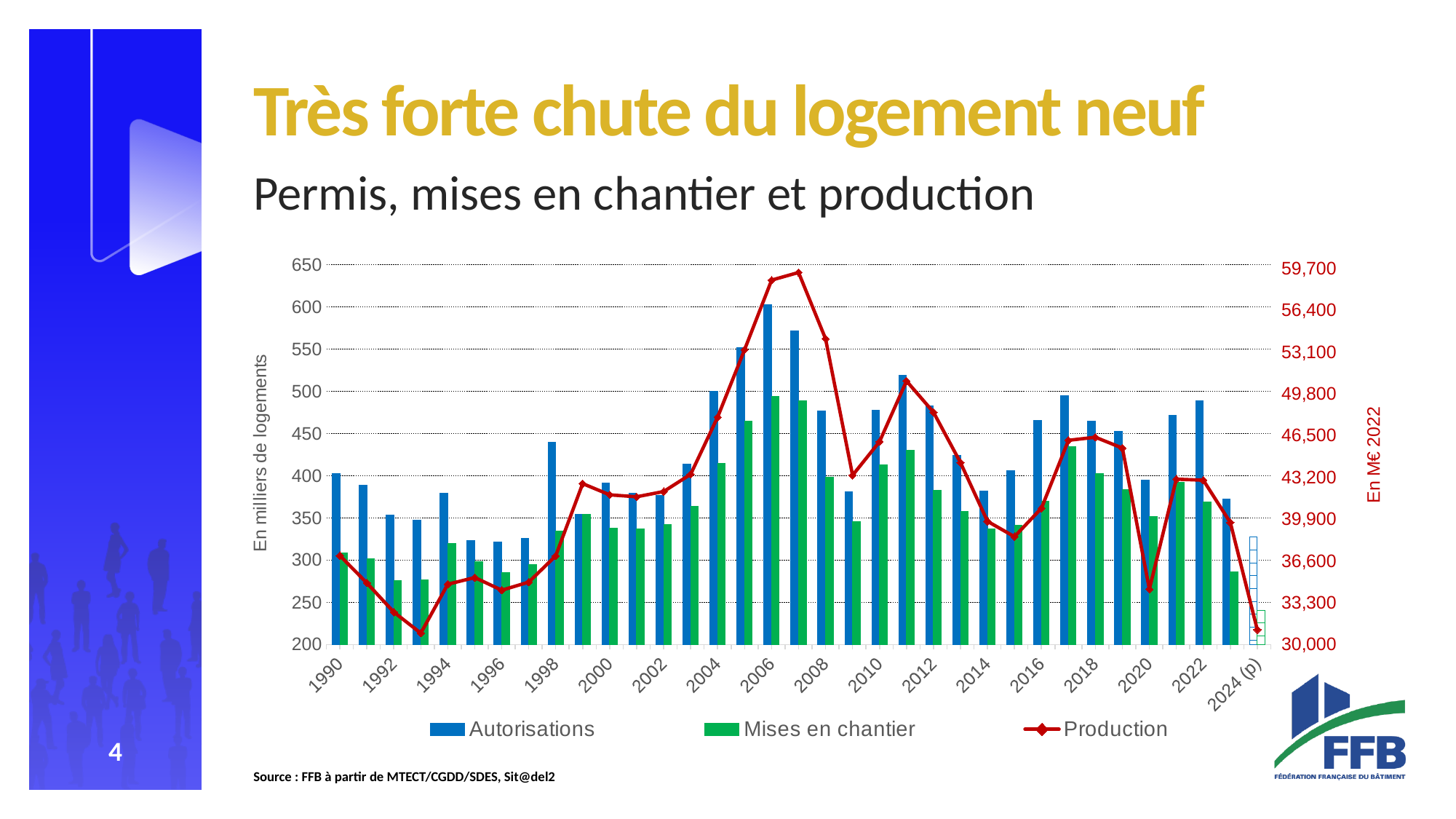
In which year is the Autorisations bar the lowest? 1996 What kind of chart is shown on the slide? A combined bar and line chart Is the Mises en chantier value for 1992 greater or less than 300? less In which year does the Production line reach its highest point? 2007 What is the label of the left vertical axis? En milliers de logements How many series does the legend list? 3 Is the Autorisations value for 2006 greater or less than 550? greater Which year has the larger Autorisations value, 2022 or 2023? 2022 How many years are shown along the x axis, from 1990 to 2024 (p)? 35 In which year is the Autorisations bar the highest? 2006 Does the Production line rise or fall between 2007 and 2009? It falls Is the Production value for 1993 greater or less than 33,300? less